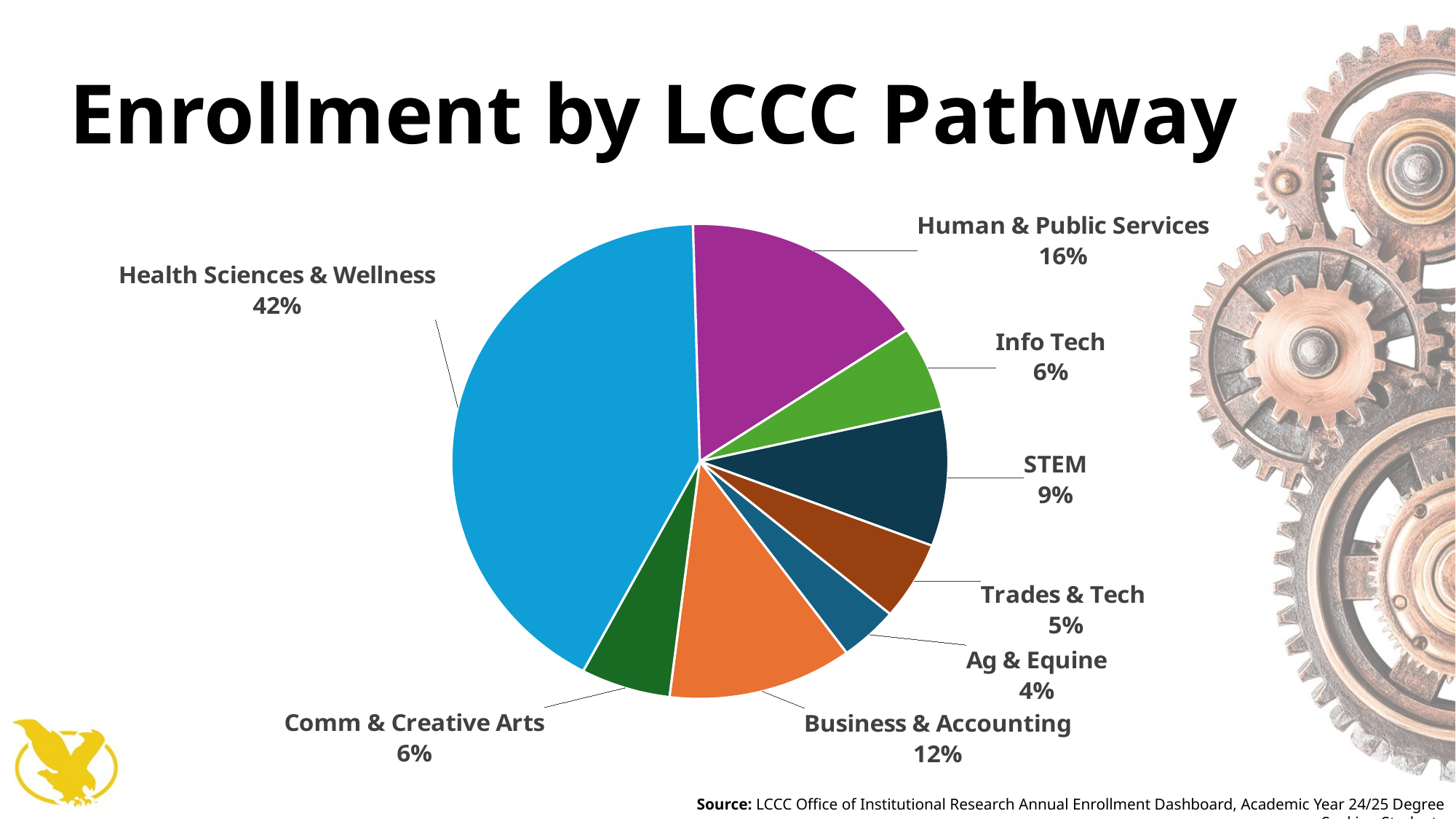
How many pathways are shown in the pie chart? 8 What share of enrollment is Human & Public Services? 16% What share of enrollment is Business & Accounting? 12% What share of enrollment is STEM? 9% Which pathway has the largest share of enrollment? Health Sciences & Wellness What share of enrollment is Health Sciences & Wellness? 42% Which has a larger share, STEM or Trades & Tech? STEM What is the title of the chart? Enrollment by LCCC Pathway What share of enrollment is Ag & Equine? 4% What kind of chart is shown on the slide? pie chart Which pathway has the smallest share of enrollment? Ag & Equine What is the difference in percentage points between Human & Public Services and Business & Accounting? 4